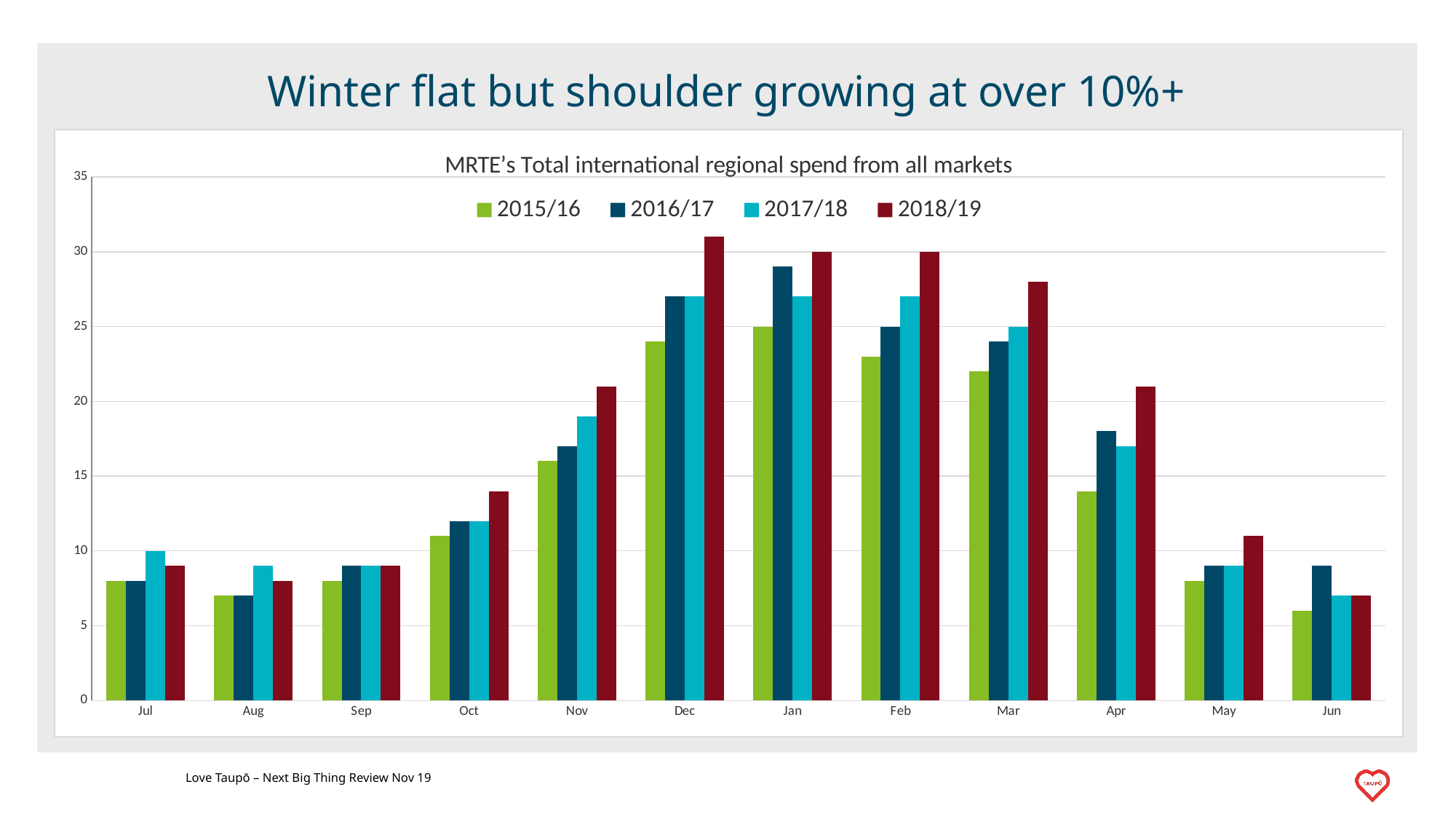
Is the value for 2018/19 in Dec greater or less than 30? greater Is the value for 2015/16 in Apr greater or less than 15? less In which month does the 2018/19 series reach its highest value? Dec How many series does the legend list? 4 Is the value for 2018/19 in Nov greater or less than 20? greater How many months are shown along the x axis? 12 What kind of chart is shown on the slide? bar chart Which series is shown in green in the legend? 2015/16 What is the title of the chart? MRTE's Total international regional spend from all markets Do the 2018/19 values rise or fall from Jul to Dec? rise In Apr, which is larger: the 2018/19 value or the 2015/16 value? 2018/19